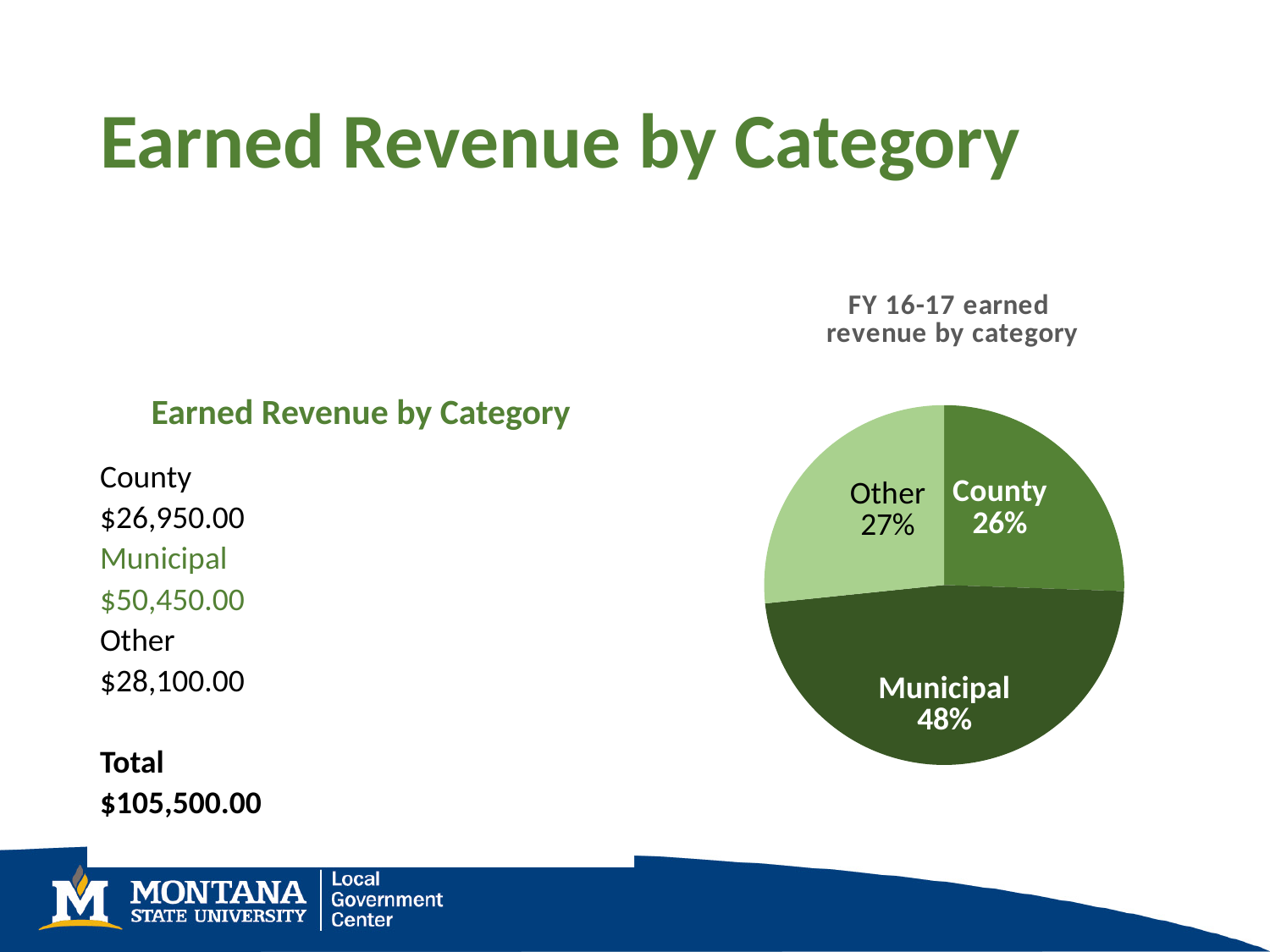
What share of the pie does Other represent? 27% What kind of chart is shown on the slide? pie chart Which category has the smallest slice of the pie? County What is the difference in percentage points between the Municipal and County slices? 22 Which slice is larger, Municipal or Other? Municipal Which category has the largest slice of the pie? Municipal What share of the pie does Municipal represent? 48% Which slice is larger, Other or County? Other Which slice of the pie is the darkest green? Municipal What is the title of the chart? FY 16-17 earned revenue by category How many slices does the pie chart have? 3 What share of the pie does County represent? 26%